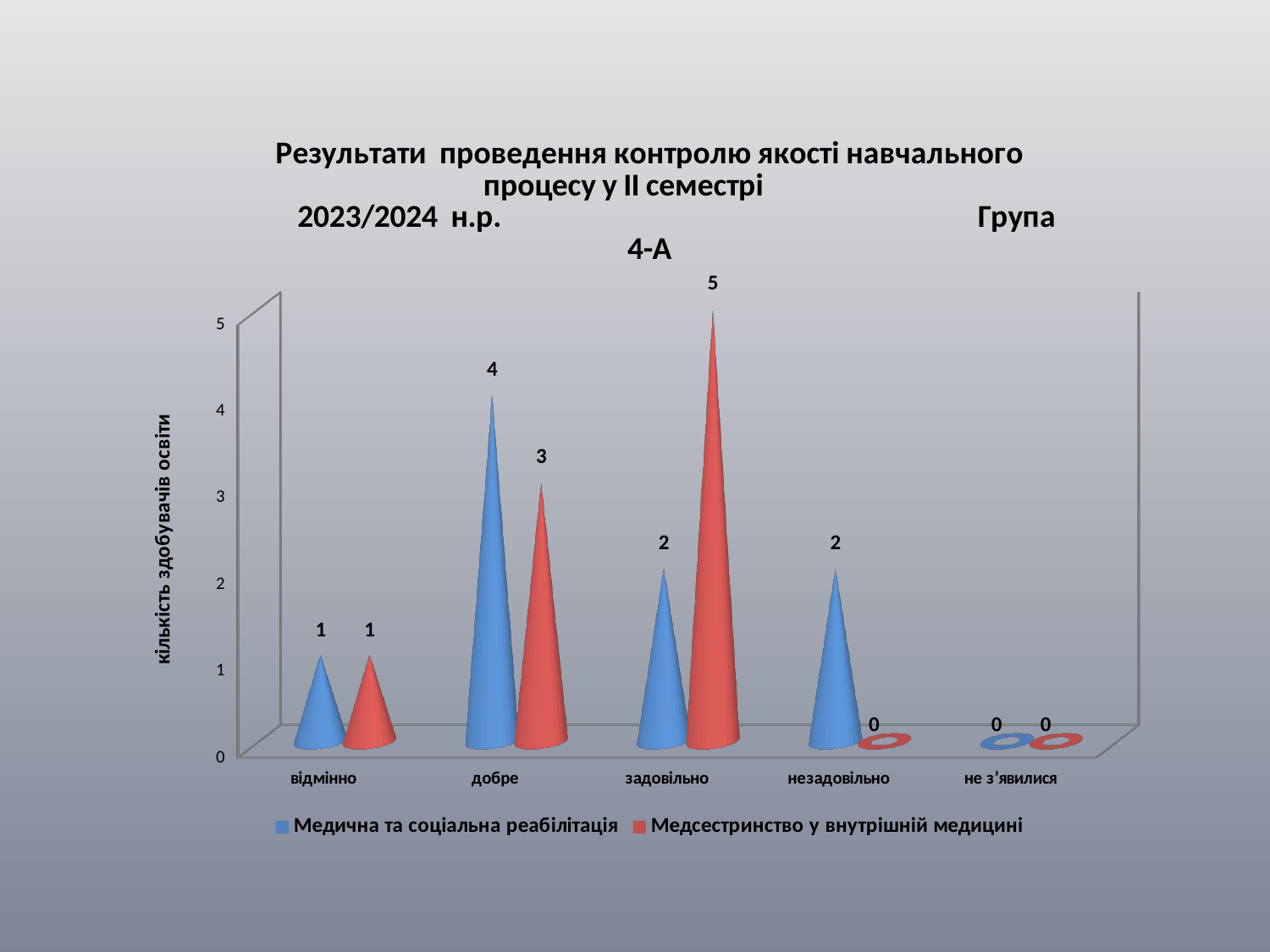
What is the label of the vertical axis? кількість здобувачів освіти For "добре", which series has the larger value? Медична та соціальна реабілітація How many categories are shown on the x axis? 5 What is the value for "незадовільно" in the "Медсестринство у внутрішній медицині" series? 0 What is the value for "добре" in the "Медична та соціальна реабілітація" series? 4 Which category has the highest value in the "Медсестринство у внутрішній медицині" series? задовільно What is the difference between the "Медсестринство у внутрішній медицині" and "Медична та соціальна реабілітація" values for "задовільно"? 3 Which category has the highest value in the "Медична та соціальна реабілітація" series? добре What kind of chart is shown on the slide? bar chart What is the value for "задовільно" in the "Медсестринство у внутрішній медицині" series? 5 What is the total of the two series' values for "відмінно"? 2 How many series does the legend list? 2